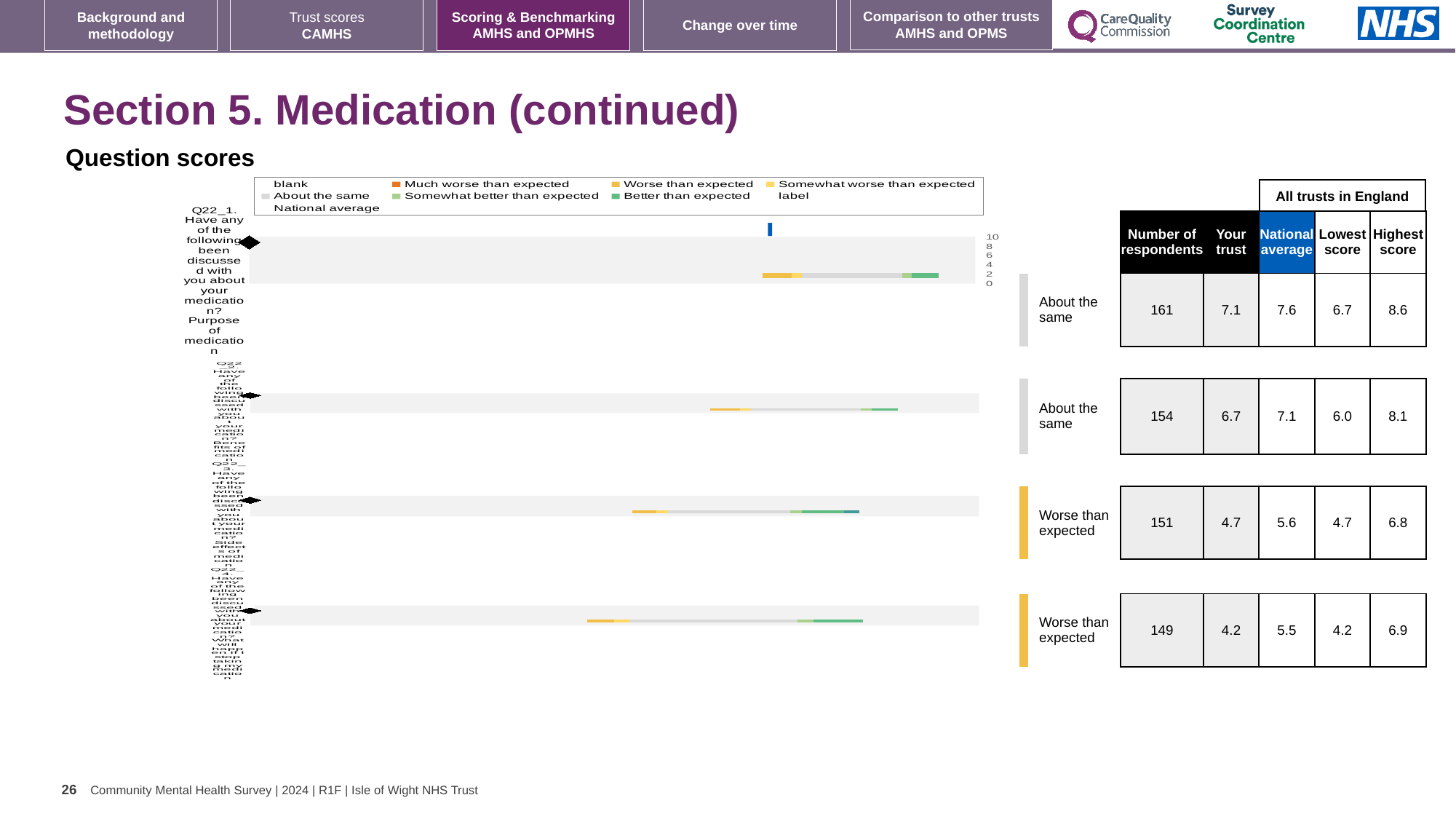
In the legend, what colour represents 'Better than expected'? Green What is the highest score across all trusts in England for the second question row? 8.1 For the second question row, which is larger: the 'Your trust' score or the national average? National average (7.1 vs 6.7) For the first row (Q22_1, purpose of medication), what is the 'Your trust' score shown in the table? 7.1 For the first row (Q22_1, purpose of medication), what is the national average score? 7.6 Which question row has the highest 'Your trust' score? The first row (Q22_1, purpose of medication), 7.1 For the third question row, what is the difference between the national average (5.6) and the 'Your trust' score (4.7)? 0.9 Which question row has the lowest 'Your trust' score? The fourth (bottom) row, 4.2 What kind of chart is used to show the question scores on this slide? bar chart How many question rows (bars) are plotted in the question scores charts? 4 How many respondents are listed for the fourth (bottom) question row? 149 What benchmark category is shown beside the third question row? Worse than expected